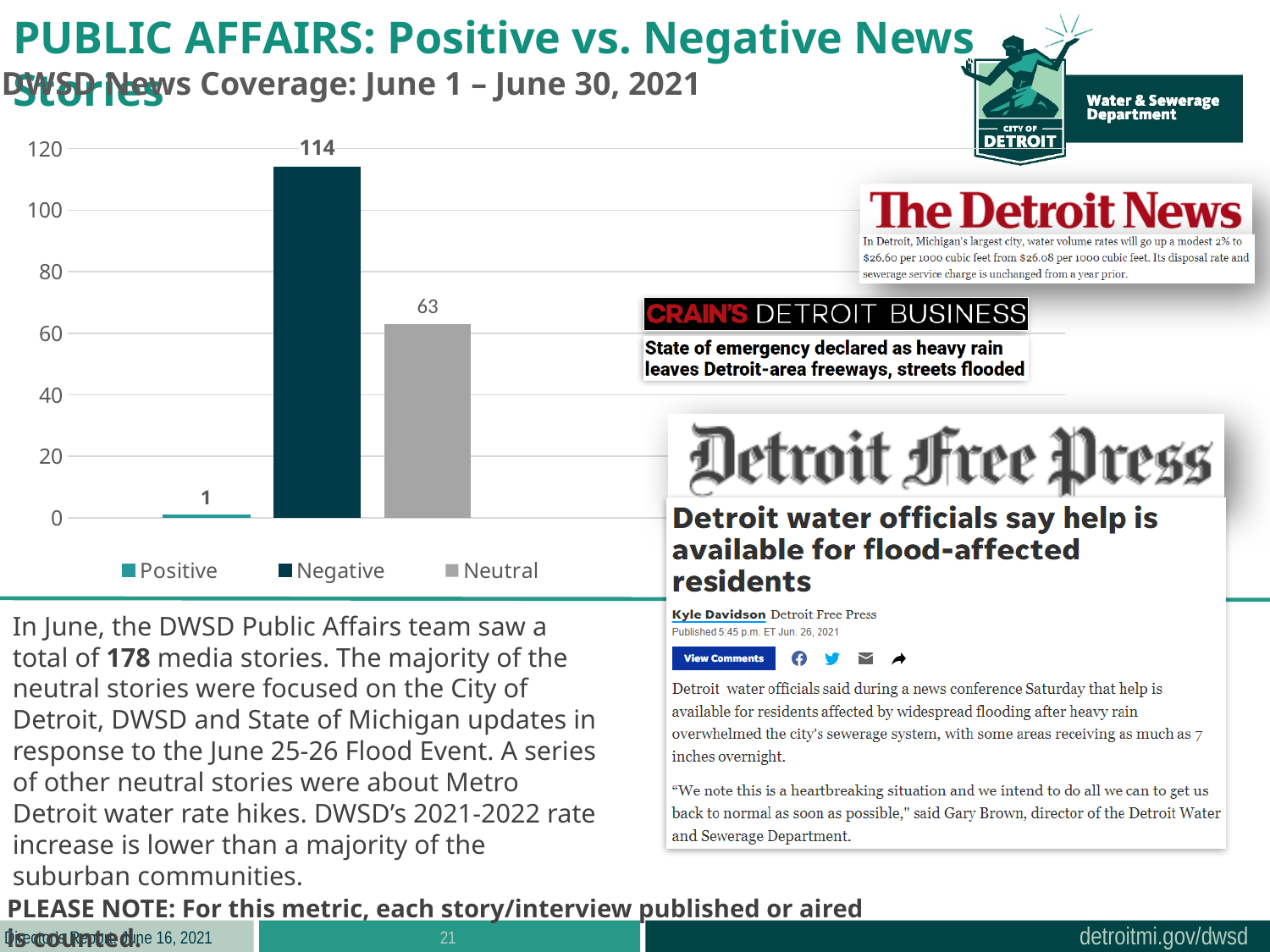
What is the value for Neutral stories? 63 Which is larger, the Negative value or the Neutral value? Negative Which category has the highest value? Negative What kind of chart is shown on the slide? bar chart How many entries does the legend list? 3 What is the value for Positive stories? 1 What is the difference between the Neutral and Positive values? 62 Which category has the lowest value? Positive What is the value for Negative stories? 114 How many categories are shown in the chart? 3 What is the difference between the Negative and Neutral values? 51 Is the value for Neutral greater or less than 80? less